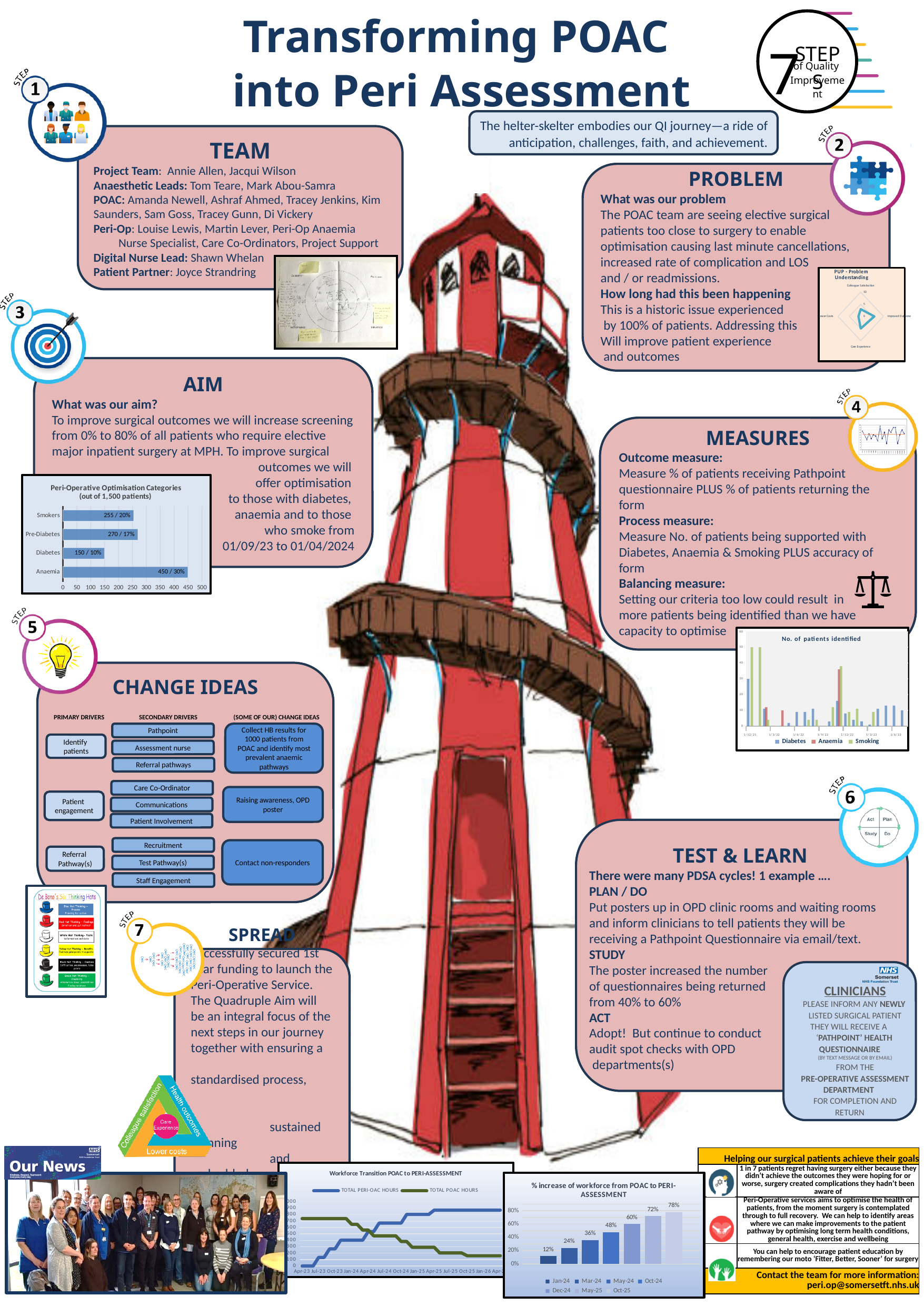
In the 'Peri-Operative Optimisation Categories' chart, which category has the lowest value? Diabetes In the '% increase of workforce from POAC to PERI-ASSESSMENT' chart, what is the highest value shown? 78% In the '% increase of workforce from POAC to PERI-ASSESSMENT' chart, do the values rise or fall from left to right? Rise In the 'Peri-Operative Optimisation Categories' chart, what is the value shown for Diabetes? 150 / 10% In the 'Peri-Operative Optimisation Categories' chart, which category has the highest value? Anaemia In the 'Peri-Operative Optimisation Categories' chart, what is the value shown for Anaemia? 450 / 30% In the 'Peri-Operative Optimisation Categories' chart, what is the difference in patient numbers between Anaemia and Smokers? 195 In the 'Peri-Operative Optimisation Categories' chart, which has more patients, Pre-Diabetes or Smokers? Pre-Diabetes In the 'Peri-Operative Optimisation Categories' chart, how many categories are shown? 4 How many series does the legend of the 'No. of patients identified' chart list? 3 What type of chart is the 'Peri-Operative Optimisation Categories' chart? Bar chart In the '% increase of workforce from POAC to PERI-ASSESSMENT' chart, what is the value for Jan-24? 12%